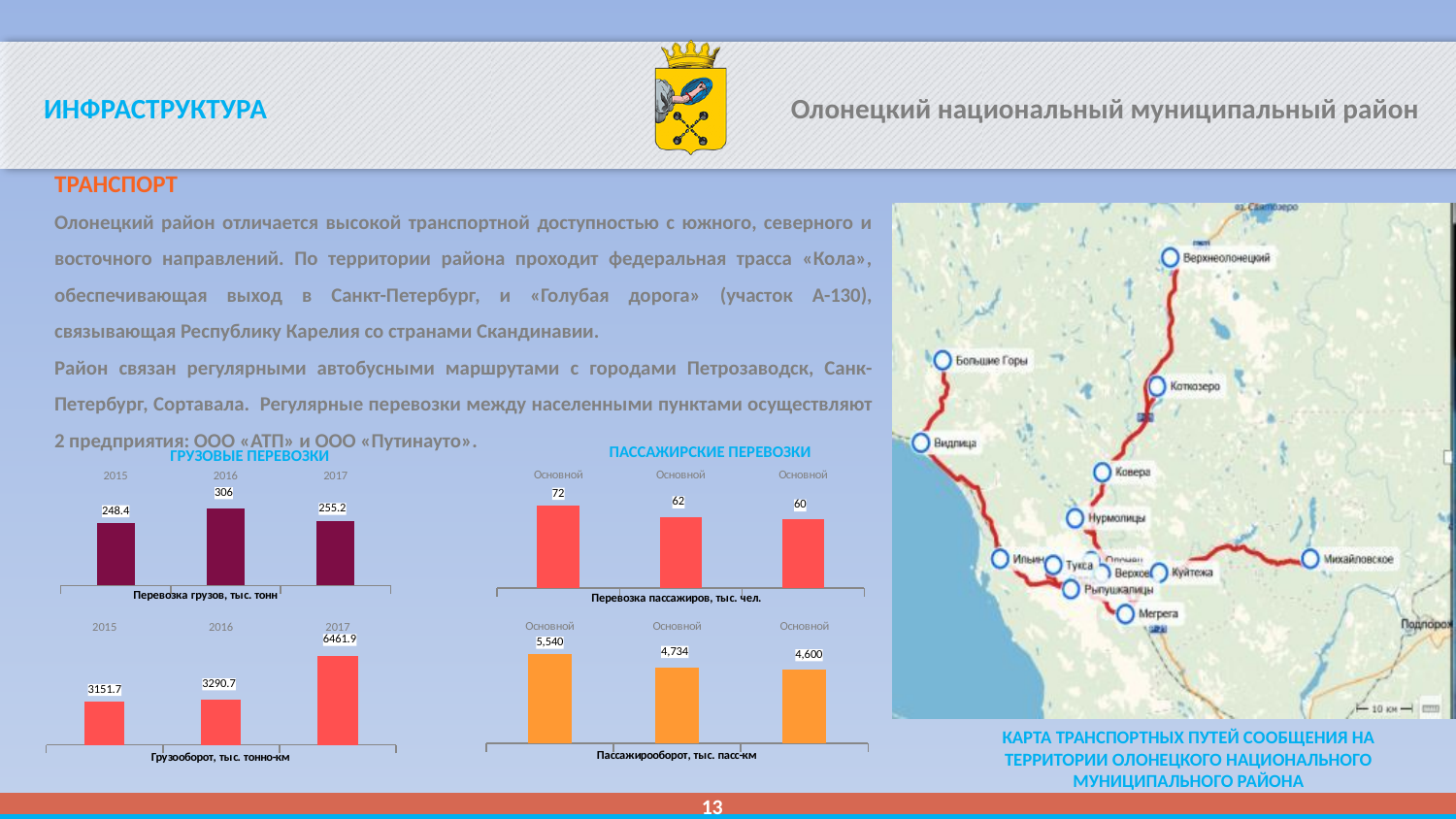
In the chart 'Перевозка пассажиров, тыс. чел.', what is the value of the first (leftmost) bar? 72 In the chart 'Грузооборот, тыс. тонно-км', how many bars are plotted? 3 In the chart 'Грузооборот, тыс. тонно-км', do the values rise or fall from 2015 to 2017? rise In the chart 'Перевозка пассажиров, тыс. чел.', do the values rise or fall from left to right? fall In the chart 'Пассажирооборот, тыс. пасс-км', what is the difference between the first and third bars? 940 In the chart 'Перевозка грузов, тыс. тонн', what is the value for 2016? 306 In the chart 'Перевозка грузов, тыс. тонн', which year has the lowest value? 2015 In the chart 'Перевозка грузов, тыс. тонн', what is the difference between the 2016 and 2017 values? 50.8 In the chart 'Пассажирооборот, тыс. пасс-км', what is the value of the middle bar? 4,734 What type of chart is used for 'Перевозка грузов, тыс. тонн'? bar chart In the chart 'Грузооборот, тыс. тонно-км', what is the value for 2017? 6461.9 In the chart 'Грузооборот, тыс. тонно-км', which year has the highest value? 2017